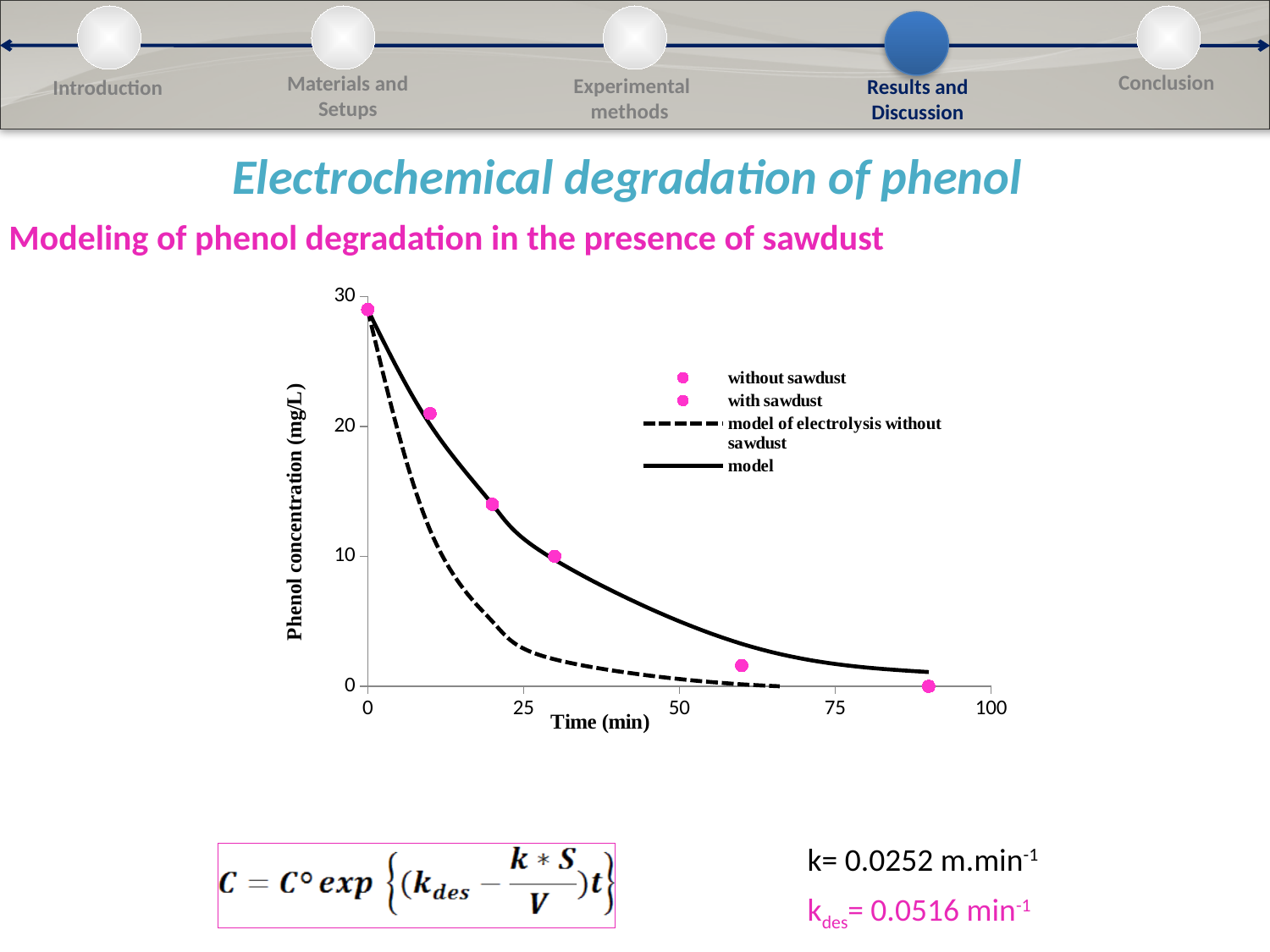
Do the plotted phenol concentration values rise or fall as time increases? fall What kind of chart is shown on the slide? scatter chart with fitted lines What is the label of the x axis of the chart? Time (min) Is the phenol concentration at time 20 min greater or less than 20 mg/L? less How many pink data points are plotted on the chart? 6 What is the highest value shown on the x axis of the chart? 100 Is the phenol concentration at time 0 greater or less than 20 mg/L? greater What is the label of the y axis of the chart? Phenol concentration (mg/L) At time 25 min, which curve is lower: the dashed line or the solid line? the dashed line How many entries does the chart legend list? 4 Is the phenol concentration at time 60 min greater or less than 10 mg/L? less